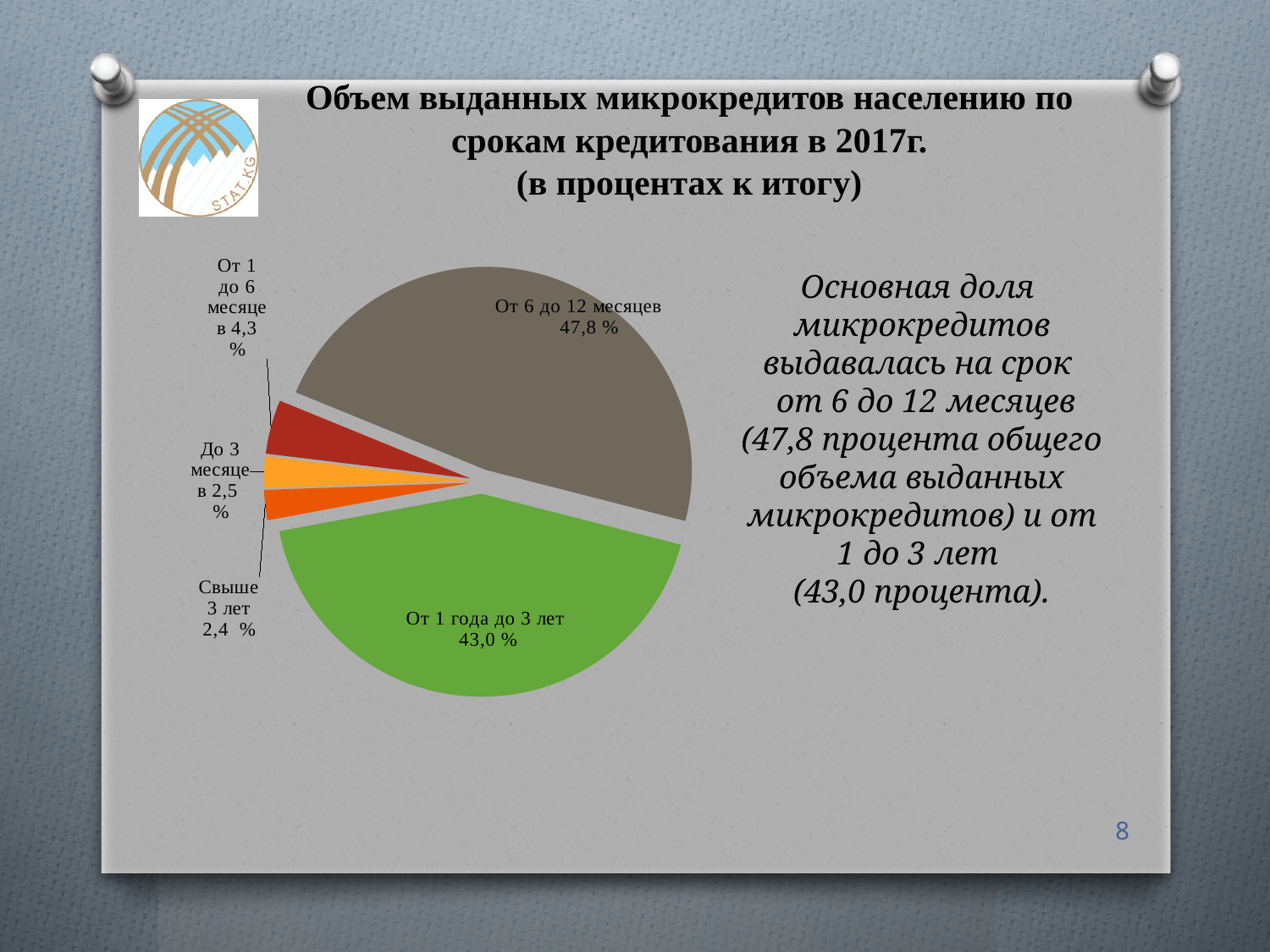
What share of microcredits was issued for a term of up to 3 months (До 3 месяцев)? 2,5 % Which loan term has the largest share of the pie? От 6 до 12 месяцев What kind of chart is shown on the slide? pie chart What colour is the slice for 1 to 3 years (От 1 года до 3 лет)? green What is the difference in percentage points between the share for 6 to 12 months and the share for 1 to 3 years? 4,8 Which is larger: the share for 1 to 6 months or the share for up to 3 months? От 1 до 6 месяцев What share of microcredits was issued for a term of 1 to 6 months (От 1 до 6 месяцев)? 4,3 % How many slices does the pie chart have? 5 Which loan term has the smallest share of the pie? Свыше 3 лет What share of microcredits was issued for a term of over 3 years (Свыше 3 лет)? 2,4 % What share of microcredits was issued for a term of 6 to 12 months (От 6 до 12 месяцев)? 47,8 % What share of microcredits was issued for a term of 1 to 3 years (От 1 года до 3 лет)? 43,0 %